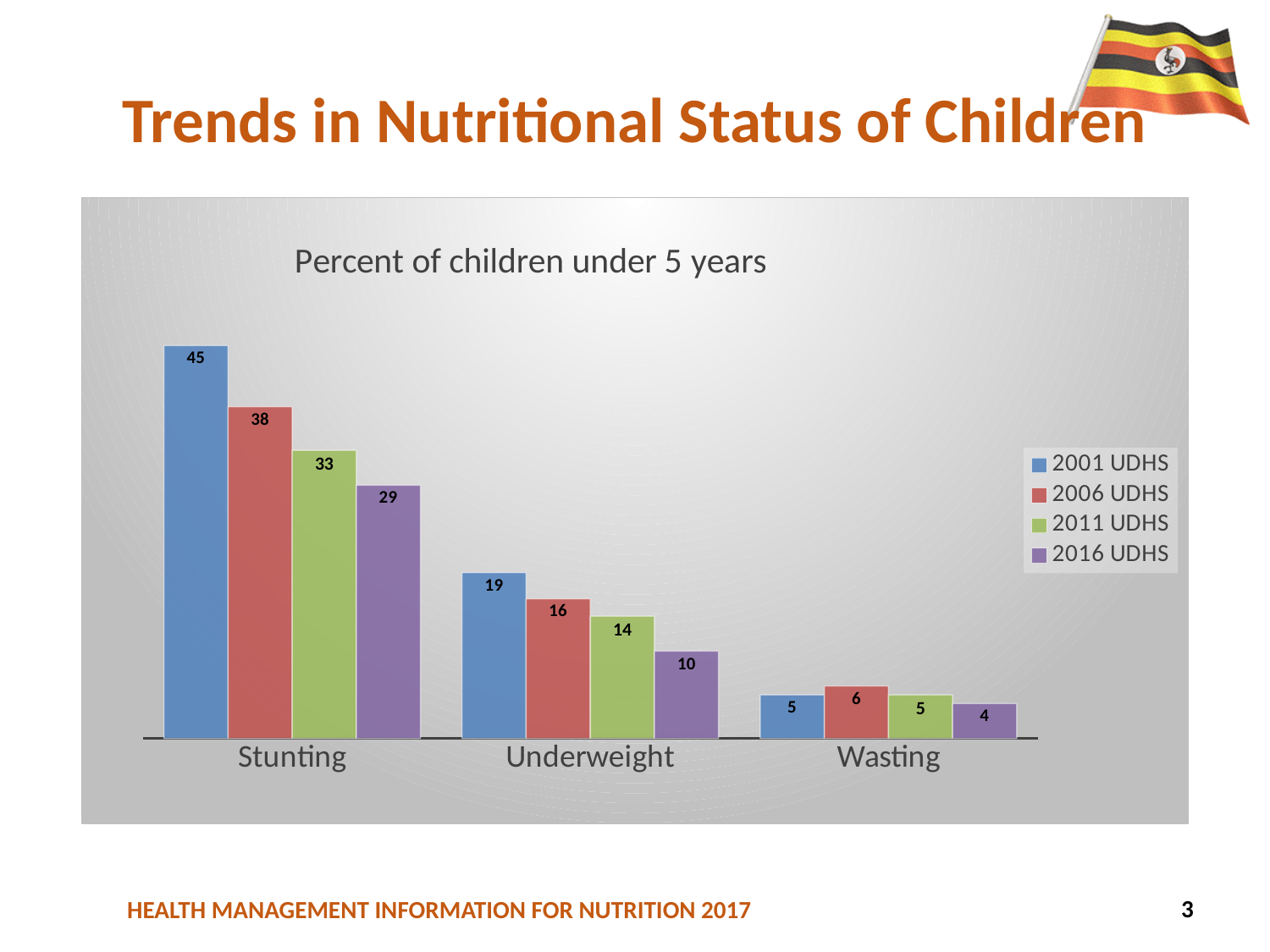
What is the value for Stunting in the 2001 UDHS series? 45 What is the difference between the 2001 UDHS and 2016 UDHS values for Stunting? 16 Which is larger: the 2006 UDHS value for Underweight or the 2011 UDHS value for Underweight? 2006 UDHS Which category has the highest value in the 2011 UDHS series? Stunting How many categories are shown on the x axis? 3 What is the title of the chart? Percent of children under 5 years What kind of chart is shown on the slide? Bar chart What is the value for Wasting in the 2006 UDHS series? 6 How many series does the legend list? 4 Which category has the lowest value in the 2016 UDHS series? Wasting Do the Stunting values rise or fall from 2001 UDHS to 2016 UDHS? Fall What is the value for Underweight in the 2016 UDHS series? 10